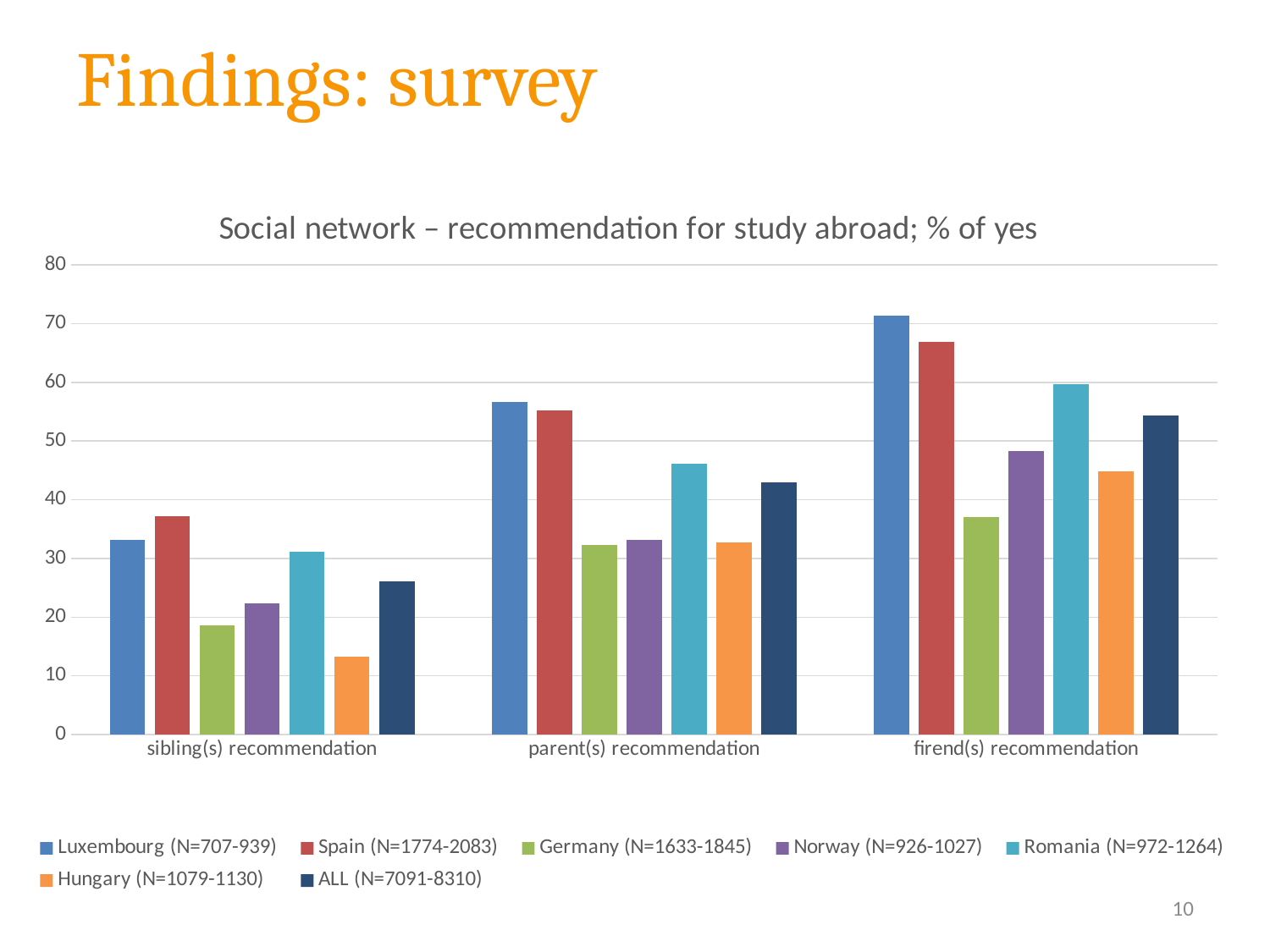
Which series has the lowest value for sibling(s) recommendation? Hungary (N=1079-1130) For sibling(s) recommendation, which is larger: Spain or Luxembourg? Spain Is the value for Hungary under sibling(s) recommendation greater or less than 20? less What kind of chart is shown on the slide? bar chart For firend(s) recommendation, which is larger: Romania or Norway? Romania Which series has the lowest value for firend(s) recommendation? Germany (N=1633-1845) How many series does the legend list? 7 Do the values for the ALL series rise or fall from sibling(s) recommendation to firend(s) recommendation? rise How many recommendation categories are shown on the x axis? 3 Is the value for Romania under parent(s) recommendation greater or less than 40? greater Is the value for Luxembourg under firend(s) recommendation greater or less than 60? greater Which country has the highest value for firend(s) recommendation? Luxembourg (N=707-939)